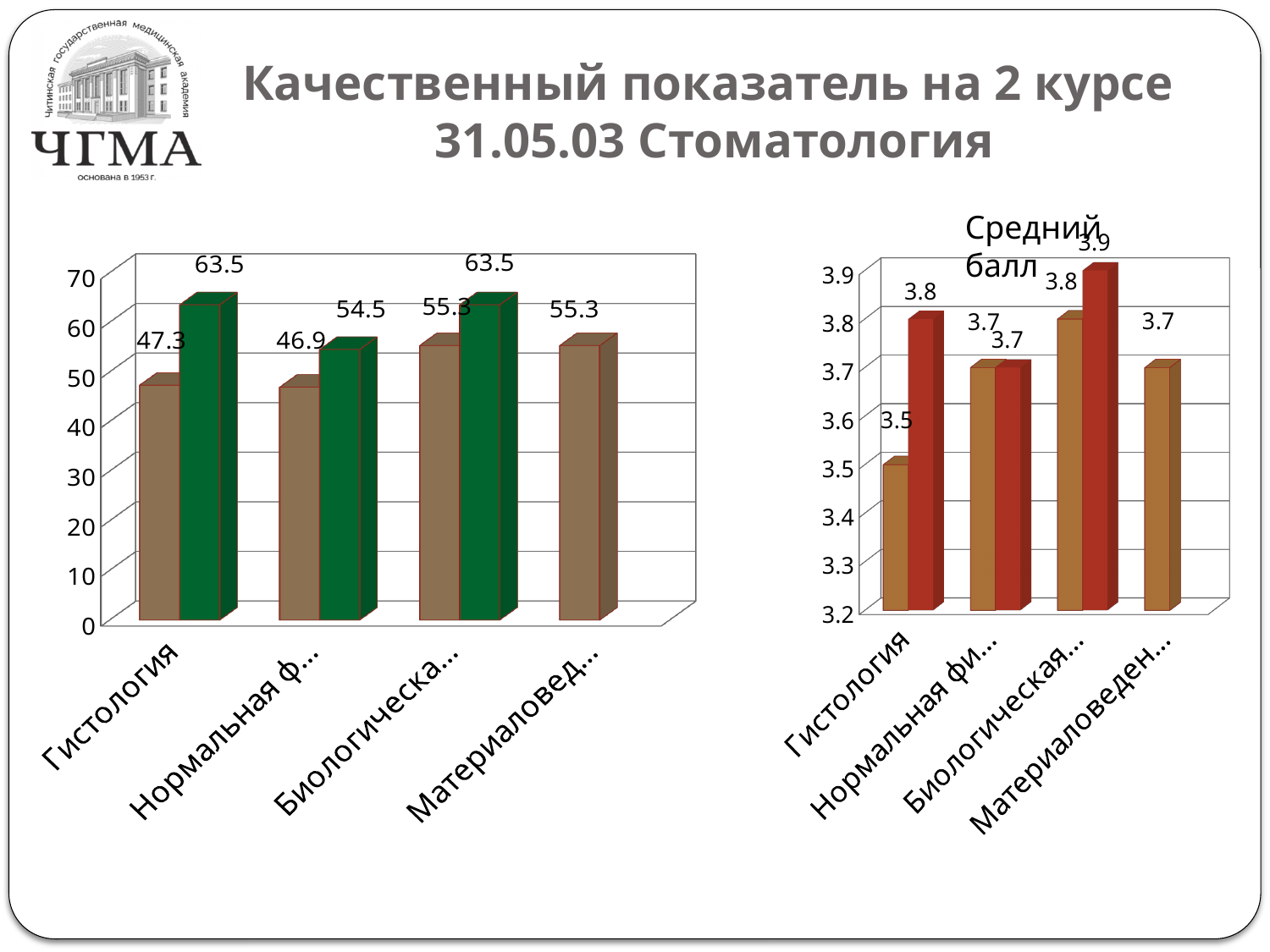
On the chart titled Средний балл, what is the value of the second (red) bar for Гистология? 3.8 On the chart titled Средний балл, what is the highest value shown by a data label? 3.9 On the left chart, what is the value of the first (brown) bar for Гистология? 47.3 On the left chart, what is the difference between the green bar and the brown bar for Гистология? 16.2 What kind of chart is the chart on the left side of the slide? bar chart How many categories are shown on the x axis of the chart titled Средний балл? 4 On the left chart, what is the lowest value shown by a data label? 46.9 On the chart titled Средний балл, what is the value of the first bar for Гистология? 3.5 What is the title of the chart on the right side of the slide? Средний балл On the left chart, what is the value of the second (green) bar for Гистология? 63.5 On the left chart, is the value of the brown bar for Гистология greater or less than 50? less On the chart titled Средний балл, which bar for Гистология is larger, the first (brown) or the second (red)? the second (red)